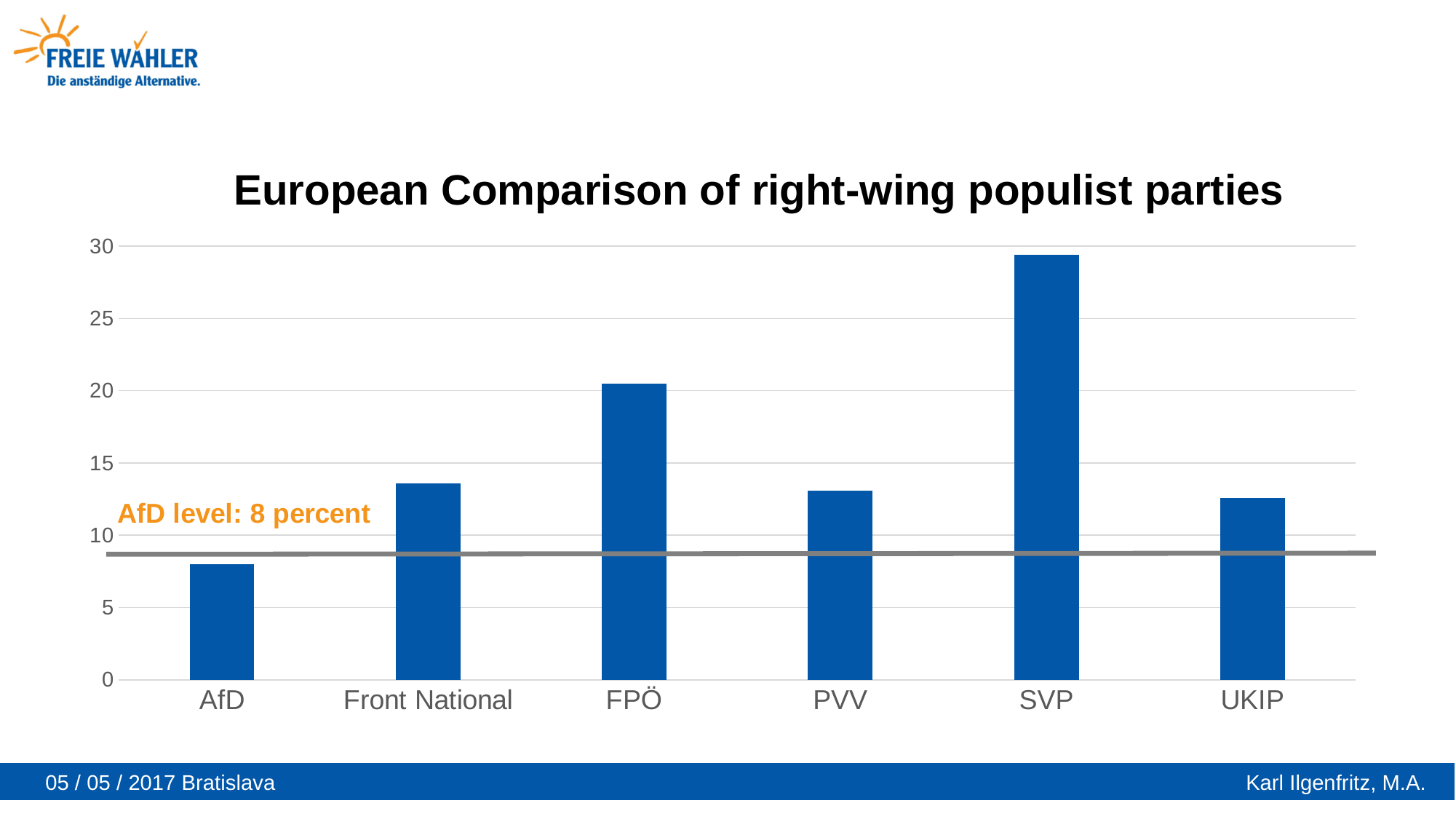
Which has the larger value, FPÖ or Front National? FPÖ What kind of chart is shown on the slide? bar chart Which party has the highest bar in the chart? SVP What is the title of the chart? European Comparison of right-wing populist parties According to the annotation on the chart, what is the AfD level? 8 percent Is the value for UKIP greater or less than 10? greater Is the value for FPÖ greater or less than 15? greater Which party has the lowest bar in the chart? AfD Is the value for PVV greater or less than 15? less How many parties are shown on the x axis of the chart? 6 Which has the larger value, SVP or FPÖ? SVP